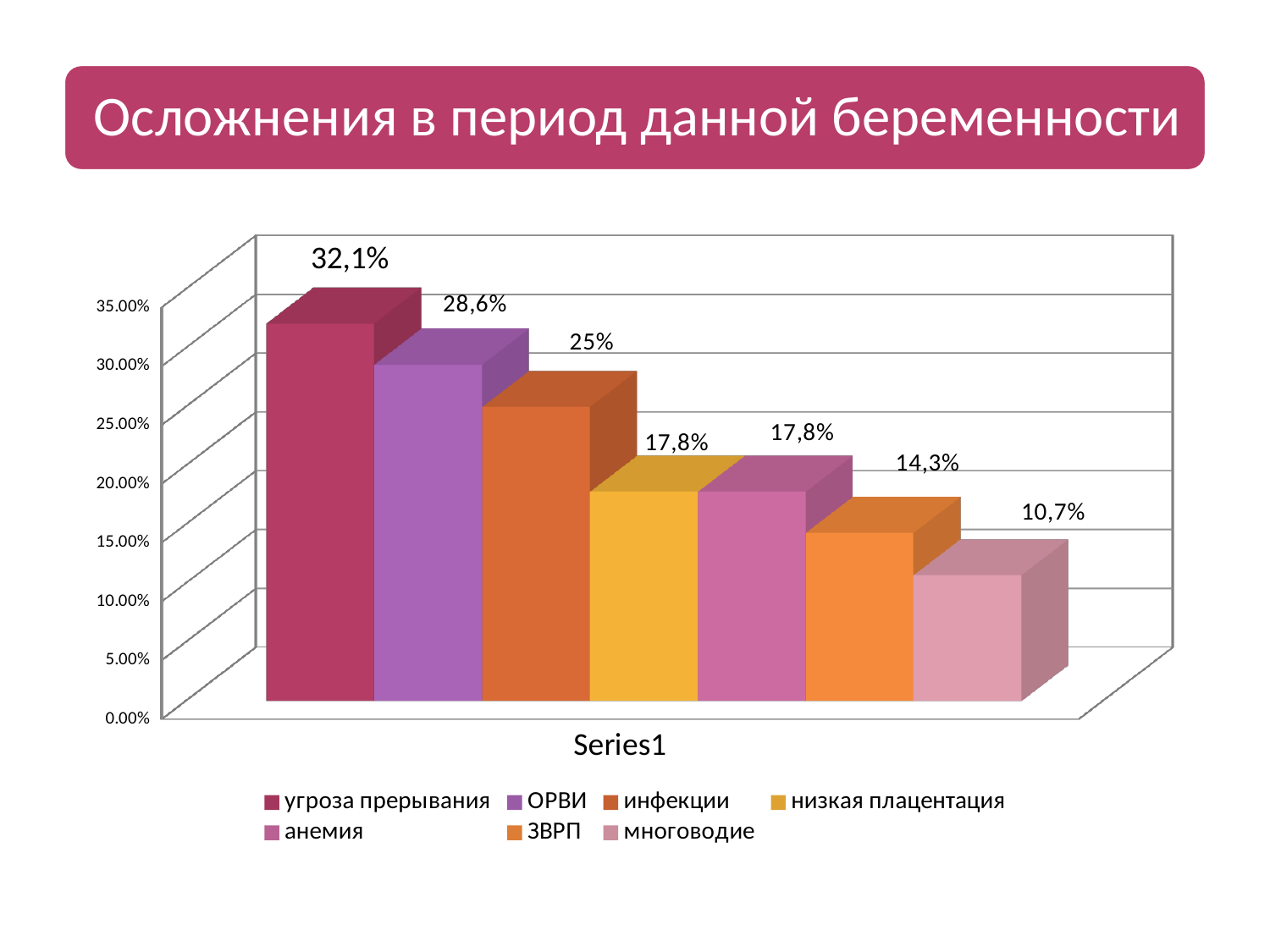
Which complication has the highest value? угроза прерывания What value is shown for угроза прерывания? 32,1% What type of chart is shown on the slide? bar chart How many bars are plotted in the chart? 7 Which complication has the lowest value? многоводие What value is shown for ЗВРП? 14,3% What is the difference between the values for инфекции and многоводие? 14,3% What value is shown for многоводие? 10,7% What value is shown for ОРВИ? 28,6% How many entries does the legend list? 7 What is the difference between the values for угроза прерывания and ОРВИ? 3,5% Which is larger, the value for инфекции or the value for ЗВРП? инфекции